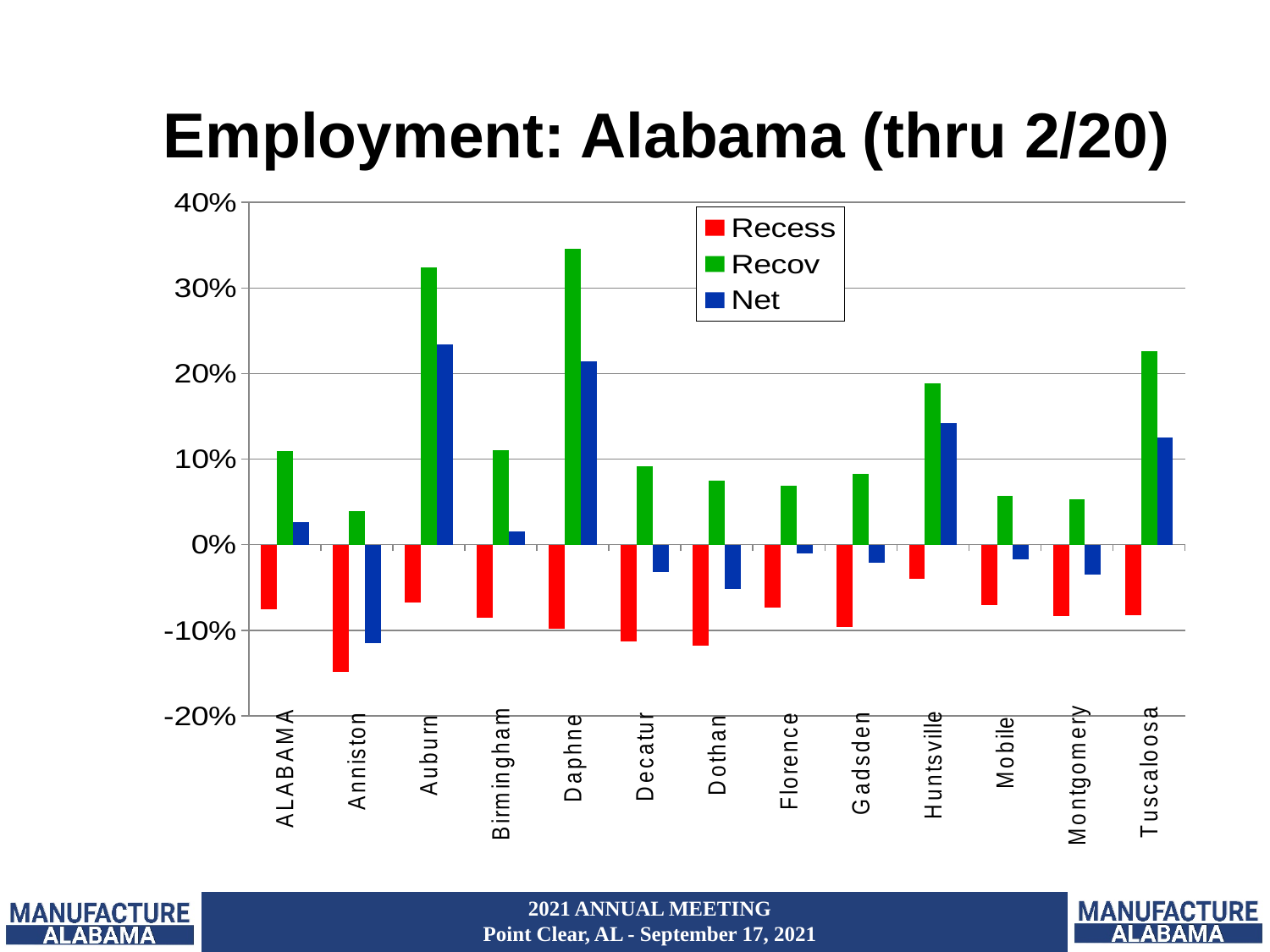
What is the title of the chart? Employment: Alabama (thru 2/20) How many categories are shown on the x axis? 13 Is the Recess value for Dothan greater or less than -10%? less What kind of chart is shown on the slide? bar chart How many series does the legend list? 3 Which category has the lowest Recess value? Anniston Is the Recov value for Auburn greater or less than 30%? greater Which category has the highest Recov value? Daphne Is the Net value for Huntsville greater or less than 10%? greater Which category has the lowest Net value? Anniston Which is larger, the Recov value for Auburn or the Recov value for Huntsville? Auburn